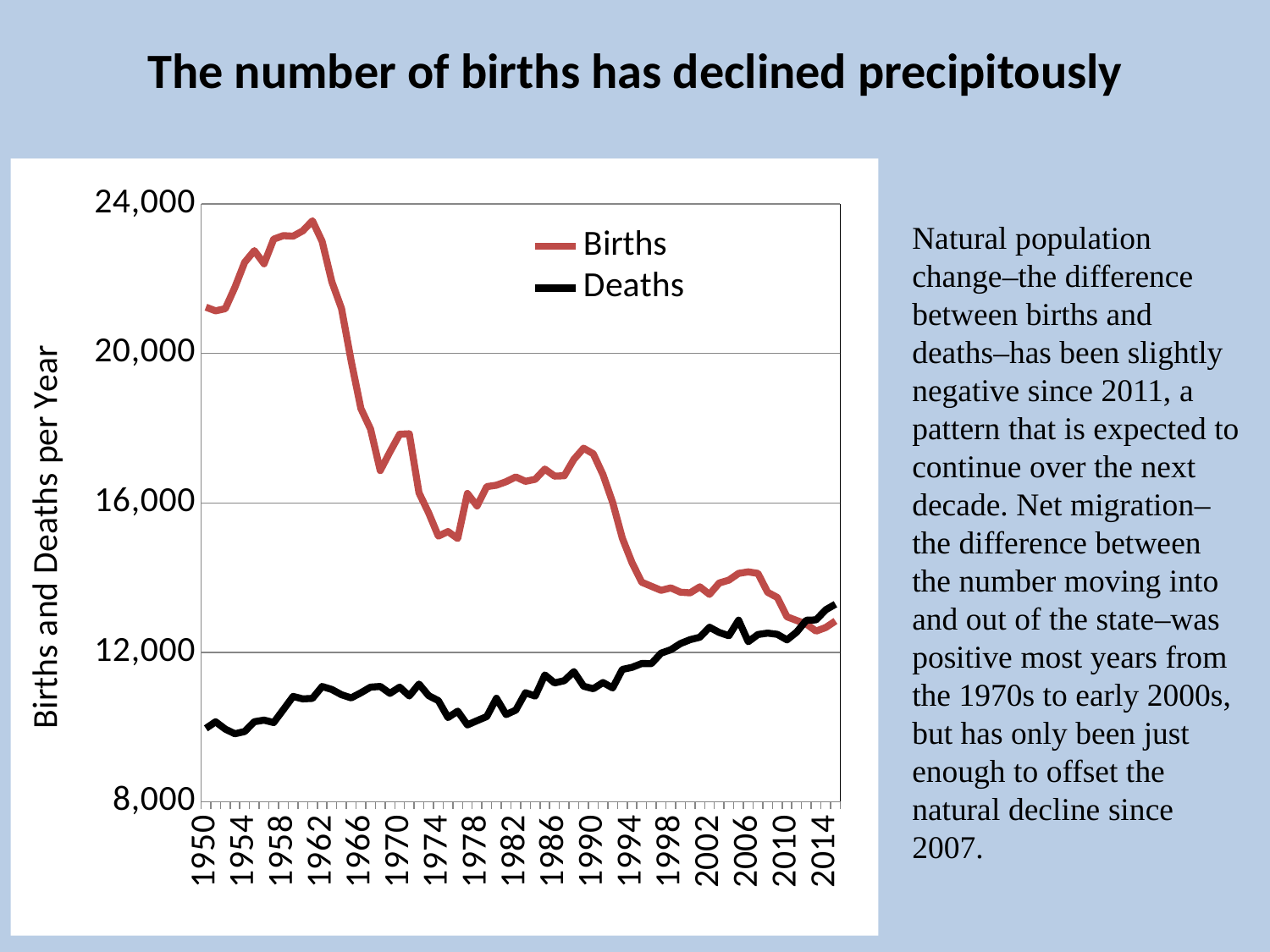
Do the Deaths values generally rise or fall from 1950 to 2014? rise What are the two series named in the chart's legend? Births and Deaths Is the value for Births in 1990 greater or less than 16,000? greater What is the title of the chart's vertical axis? Births and Deaths per Year In 1950, which series has the larger value, Births or Deaths? Births Is the value for Deaths in 2014 greater or less than 12,000? greater Is the value for Births in 1950 greater or less than 20,000? greater Do the Births values rise or fall between 1962 and 1966? fall How many series does the chart's legend list? 2 What kind of chart is shown on the slide? line chart